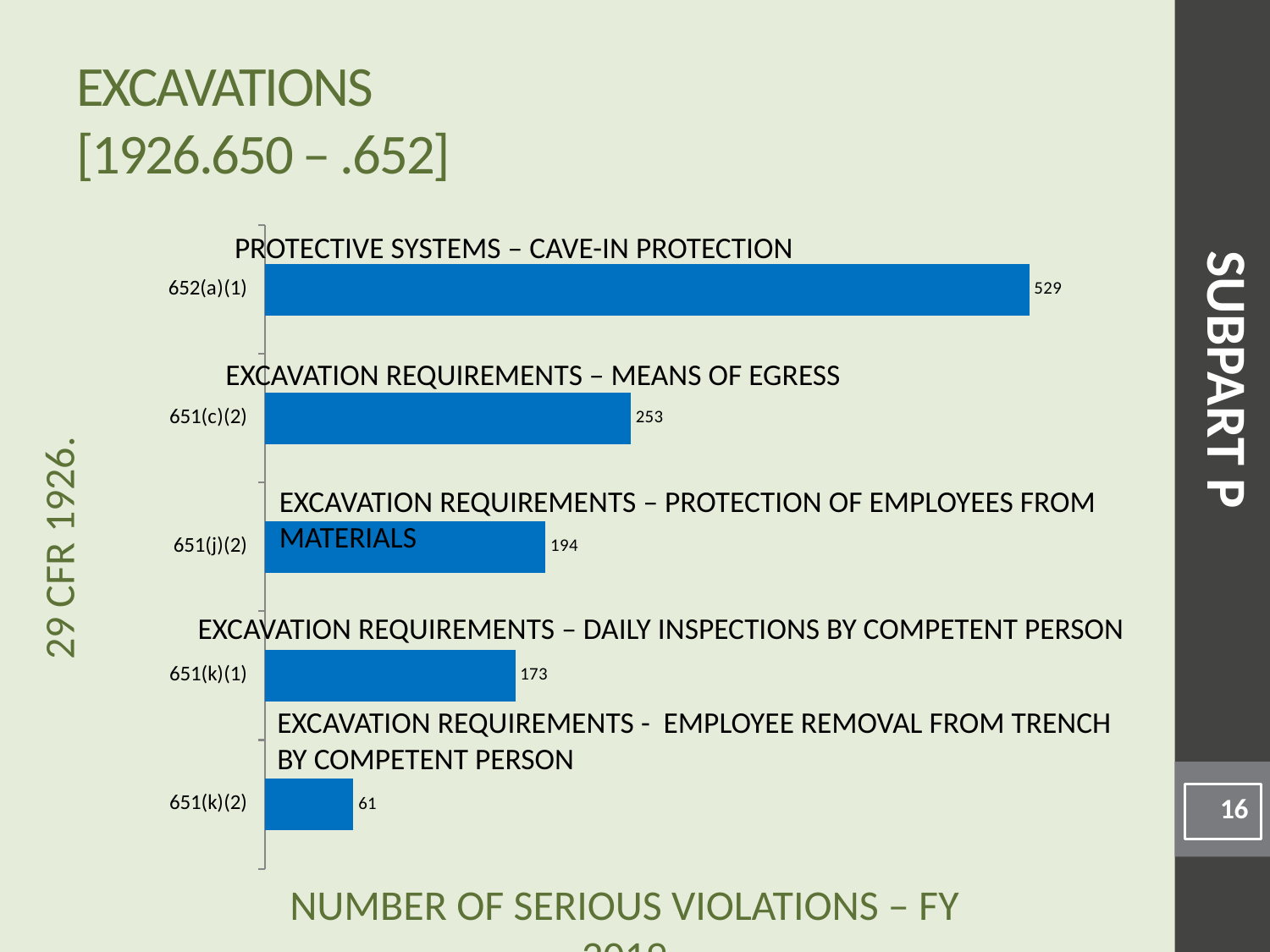
What is the difference in serious violations between 652(a)(1) and 651(c)(2)? 276 Which has more serious violations, 651(j)(2) or 651(k)(1)? 651(j)(2) Which category has the lowest number of serious violations? 651(k)(2) Which standard is labelled 'PROTECTIVE SYSTEMS – CAVE-IN PROTECTION' in the chart? 652(a)(1) What is the number of serious violations for 651(k)(1)? 173 What is the number of serious violations for 651(k)(2)? 61 Which category has the highest number of serious violations? 652(a)(1) What is the number of serious violations for 651(c)(2)? 253 What is the number of serious violations for 652(a)(1)? 529 What kind of chart is shown on the slide? Bar chart What is the number of serious violations for 651(j)(2)? 194 How many categories are shown in the chart? 5